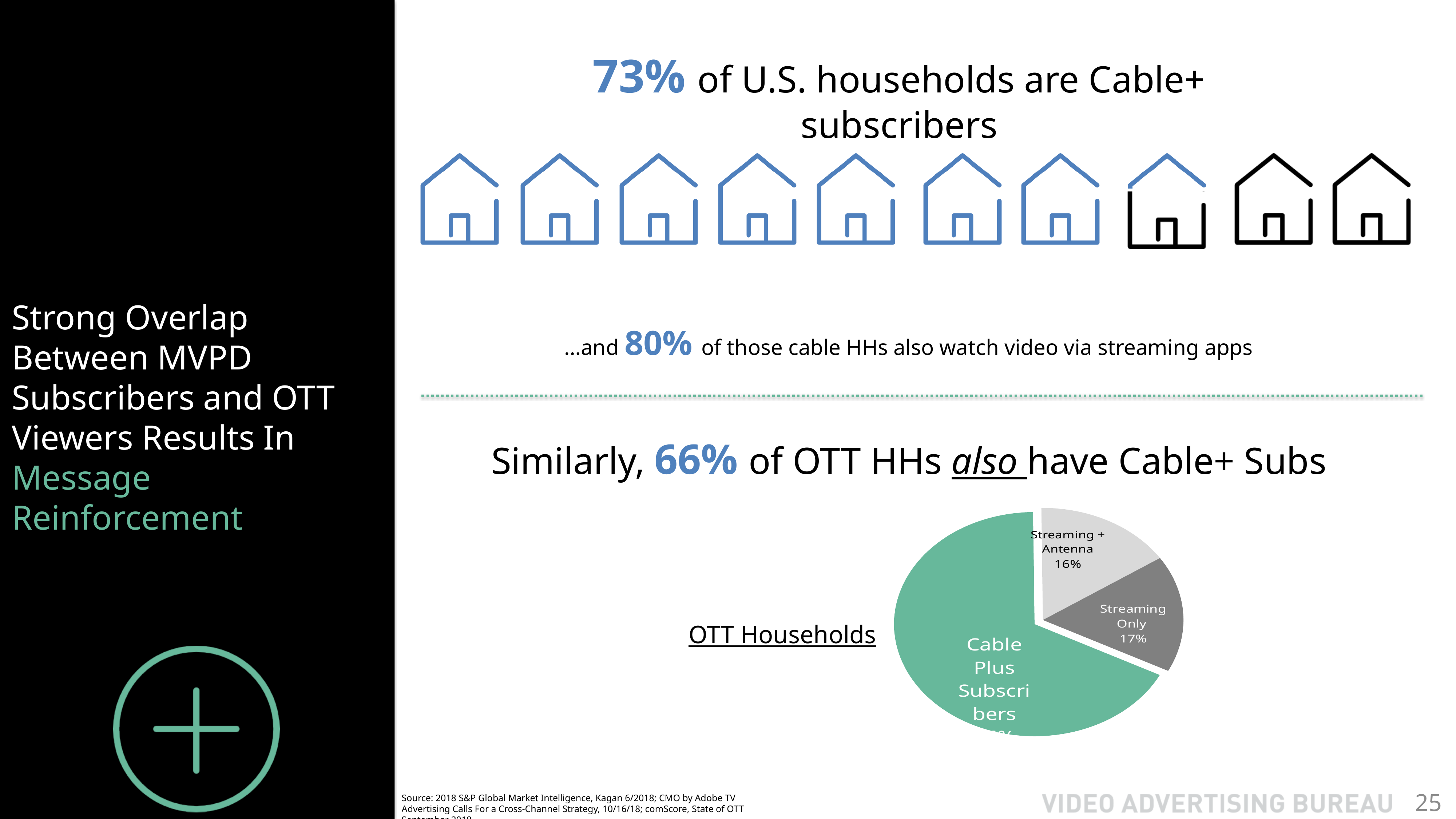
What is the title shown next to the pie chart? OTT Households Which slice of the OTT Households pie chart is the smallest? Streaming + Antenna In the OTT Households pie chart, what is the difference between the Streaming Only share and the Streaming + Antenna share? 1% In the OTT Households pie chart, is the Cable Plus Subscribers slice greater or less than 50%? greater What kind of chart is shown under the heading 'OTT Households'? pie chart How many slices does the OTT Households pie chart have? 3 In the OTT Households pie chart, what is the combined share of Streaming + Antenna and Streaming Only? 33% In the OTT Households pie chart, what share is labelled for Streaming + Antenna? 16% Which slice of the OTT Households pie chart is the largest? Cable Plus Subscribers What colour is the Cable Plus Subscribers slice in the OTT Households pie chart? green In the OTT Households pie chart, what share is labelled for Streaming Only? 17% In the OTT Households pie chart, which is larger: Streaming Only or Streaming + Antenna? Streaming Only